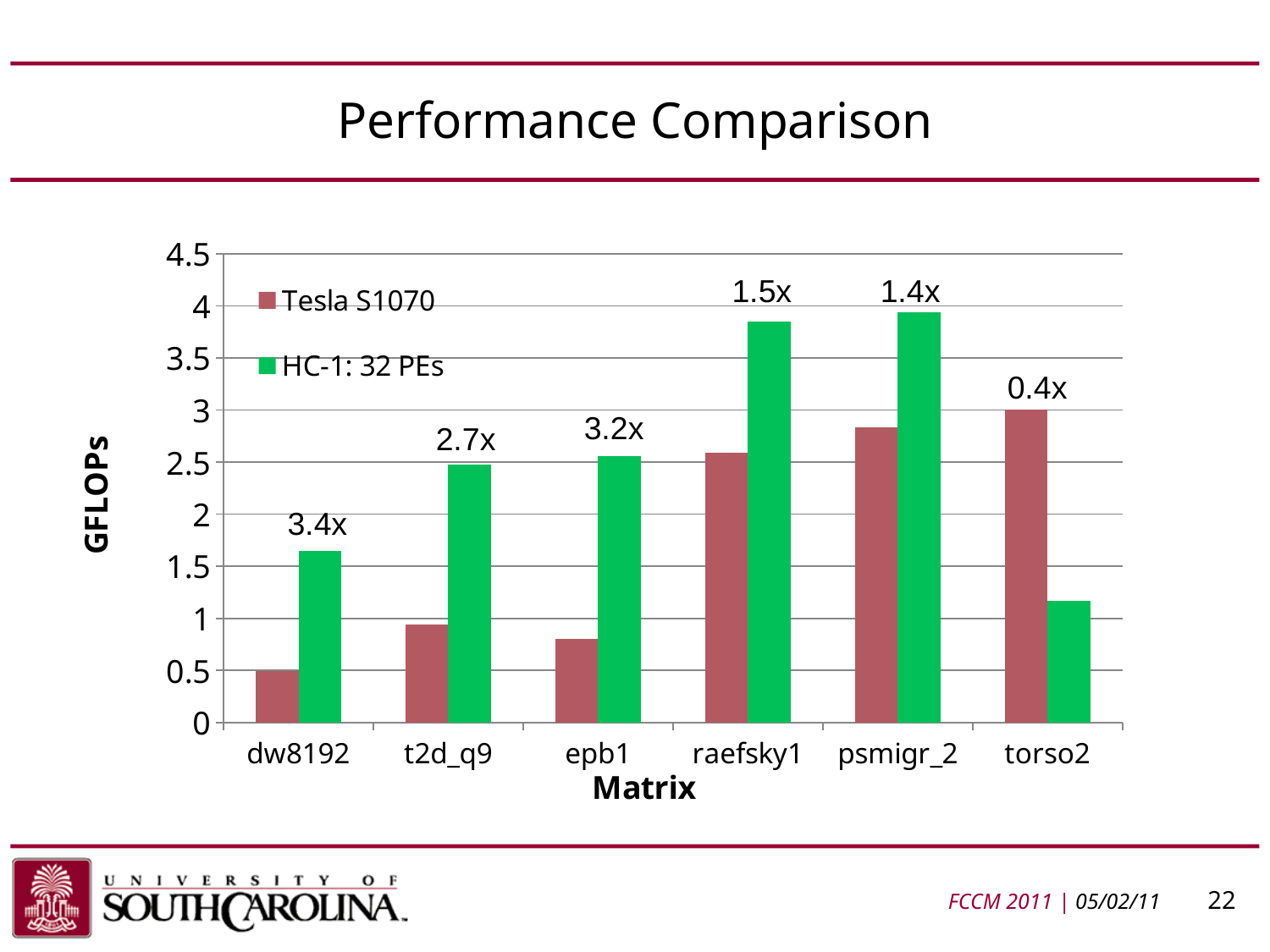
How many matrices are shown on the x axis? 6 Which matrix has the lowest Tesla S1070 value? dw8192 What kind of chart is shown on the slide? bar chart Which matrix has the lowest speedup label? torso2 What speedup label is printed above the bars for epb1? 3.2x What is the label on the y axis? GFLOPs Is the HC-1: 32 PEs value for raefsky1 greater or less than 3.5? greater Which matrix has the highest speedup label? dw8192 How many series does the legend list? 2 For torso2, which series has the larger value, Tesla S1070 or HC-1: 32 PEs? Tesla S1070 What speedup label is printed above the bars for dw8192? 3.4x Is the Tesla S1070 value for dw8192 greater or less than 1? less